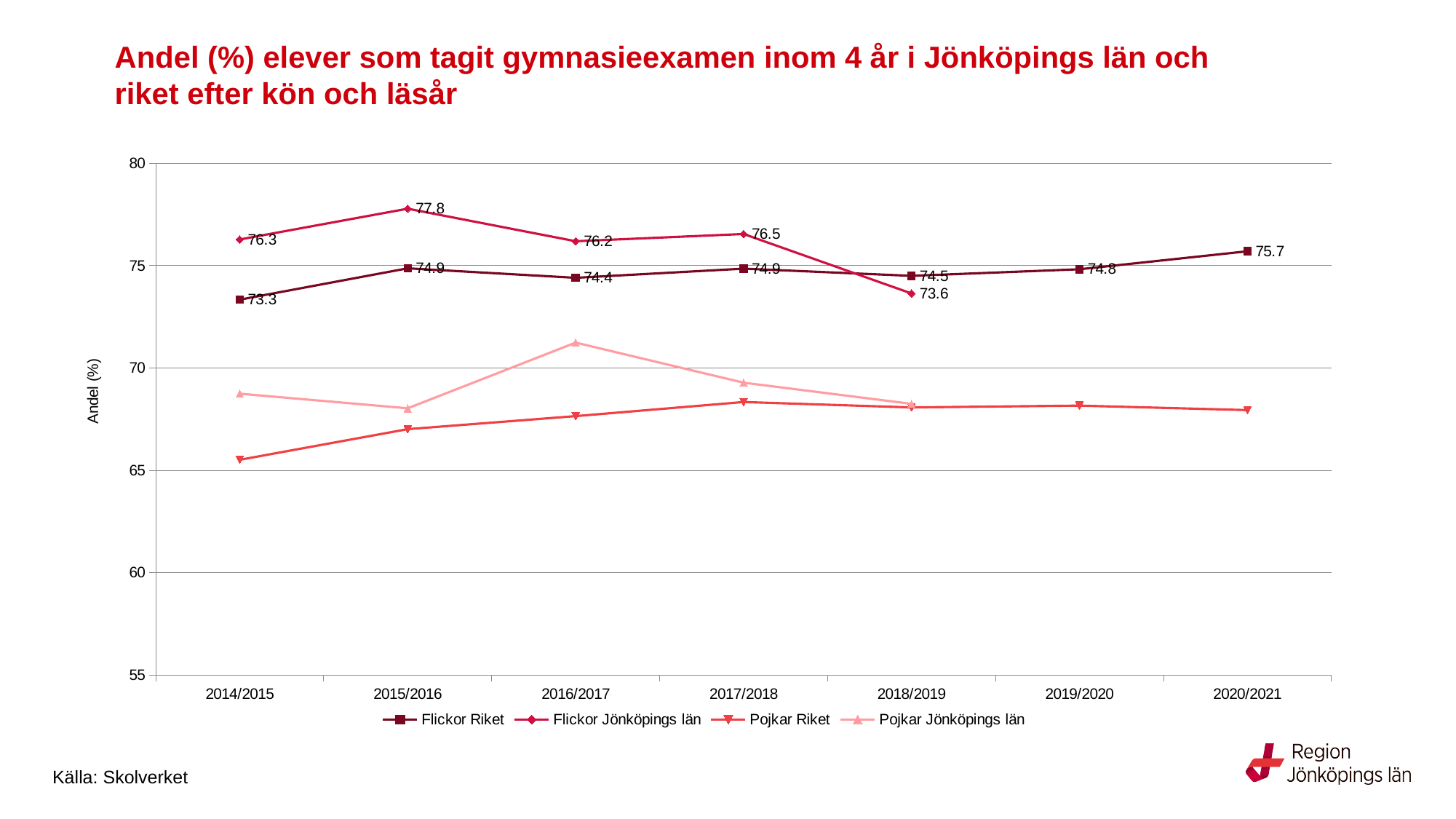
How many school years are shown on the x axis? 7 In 2018/2019, which is larger: Flickor Riket or Flickor Jönköpings län? Flickor Riket What kind of chart is shown on the slide? Line chart What is the value for Flickor Jönköpings län in 2015/2016? 77.8 How many series does the legend list? 4 In which school year is the value for Flickor Jönköpings län highest? 2015/2016 What is the value for Flickor Riket in 2020/2021? 75.7 What is the label on the y axis? Andel (%) What is the difference between the Flickor Jönköpings län values for 2015/2016 and 2016/2017? 1.6 Does the Pojkar Riket line rise or fall from 2014/2015 to 2017/2018? Rise Is the value for Pojkar Jönköpings län in 2016/2017 greater or less than 70? greater In which school year is the value for Flickor Riket lowest? 2014/2015